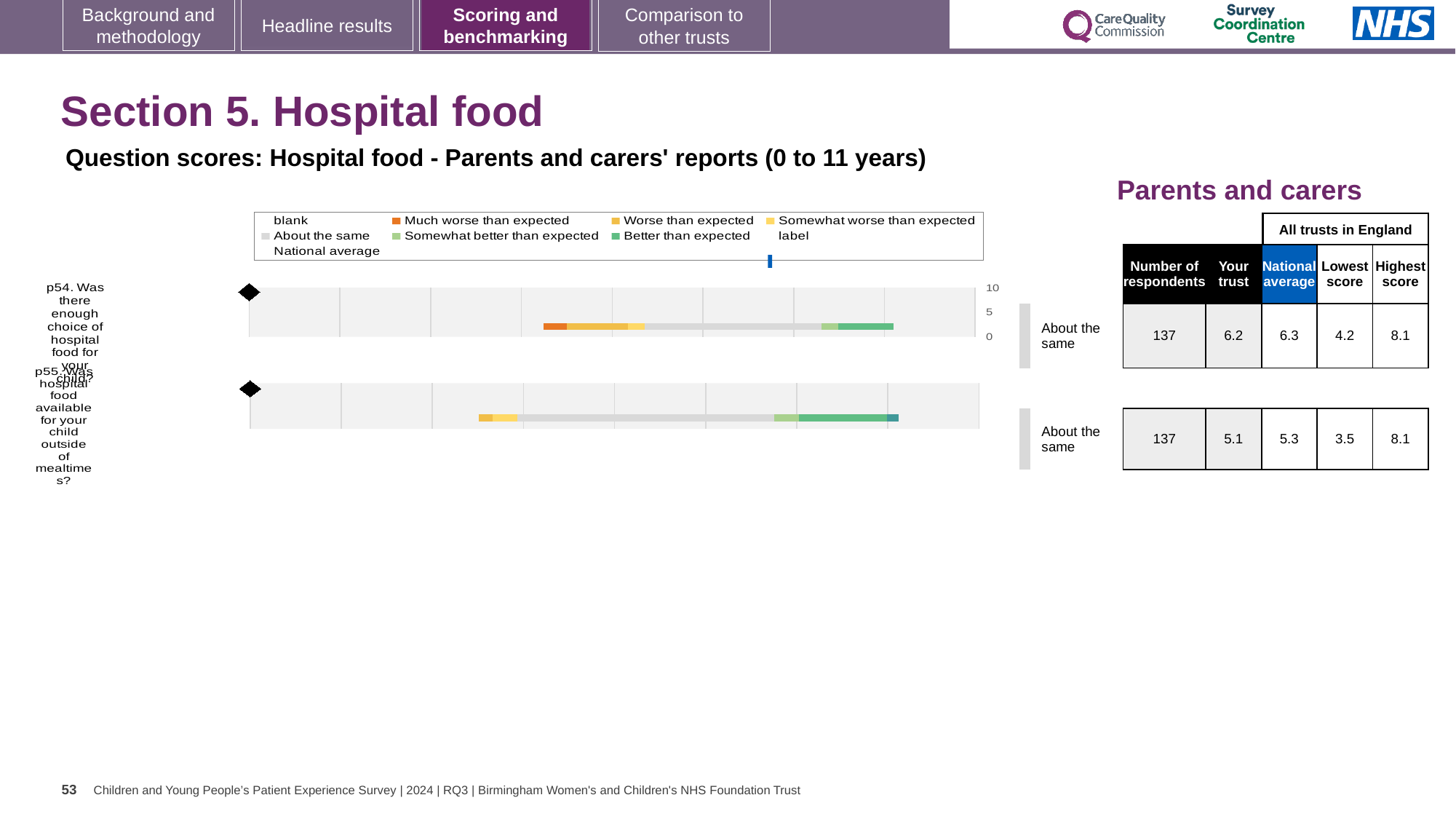
What is the national average score for p54? 6.3 How many survey questions (bars) are plotted in the chart? 2 How many respondents answered p55? 137 Which question has the higher 'Your trust' score, p54 or p55? p54 What is the 'Your trust' score for p55 (hospital food available outside of mealtimes)? 5.1 What benchmark category is shown for p54? About the same What is the maximum value shown on the chart's score axis? 10 What is the lowest score across all trusts in England for p55? 3.5 What is the difference between the 'Your trust' scores for p54 and p55? 1.1 What kind of chart is shown on the slide? bar chart What is the highest score across all trusts in England for p54? 8.1 What is the 'Your trust' score for p54 (enough choice of hospital food for your child)? 6.2